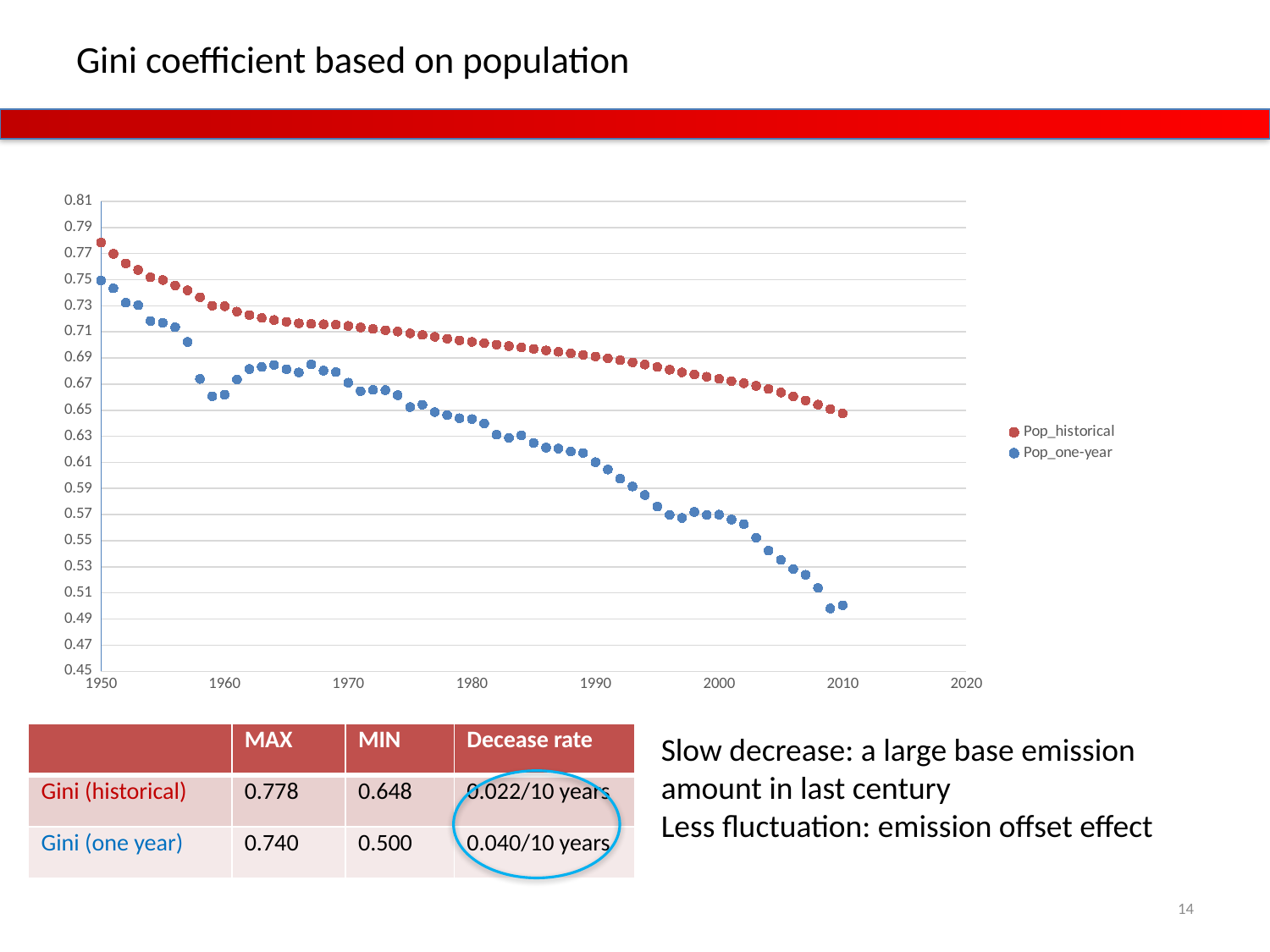
What are the two series named in the chart legend? Pop_historical and Pop_one-year According to the table below the chart, what is the MAX value for Gini (historical)? 0.778 Do the Pop_one-year values overall rise or fall from 1950 to 2010? Fall According to the table below the chart, what is the MIN value for Gini (one year)? 0.500 Which colour is used for the Pop_one-year series in the chart? Blue Around 1990, which series has the higher value, Pop_historical or Pop_one-year? Pop_historical Is the Pop_one-year value at 1990 greater or less than 0.65? less How many series does the chart legend list? 2 Do the Pop_historical values rise or fall from 1950 to 2010? Fall Is the Pop_historical value at 2010 greater or less than 0.67? less Is the Pop_historical value at 1950 greater or less than 0.75? greater What kind of chart is shown on the slide? Scatter chart